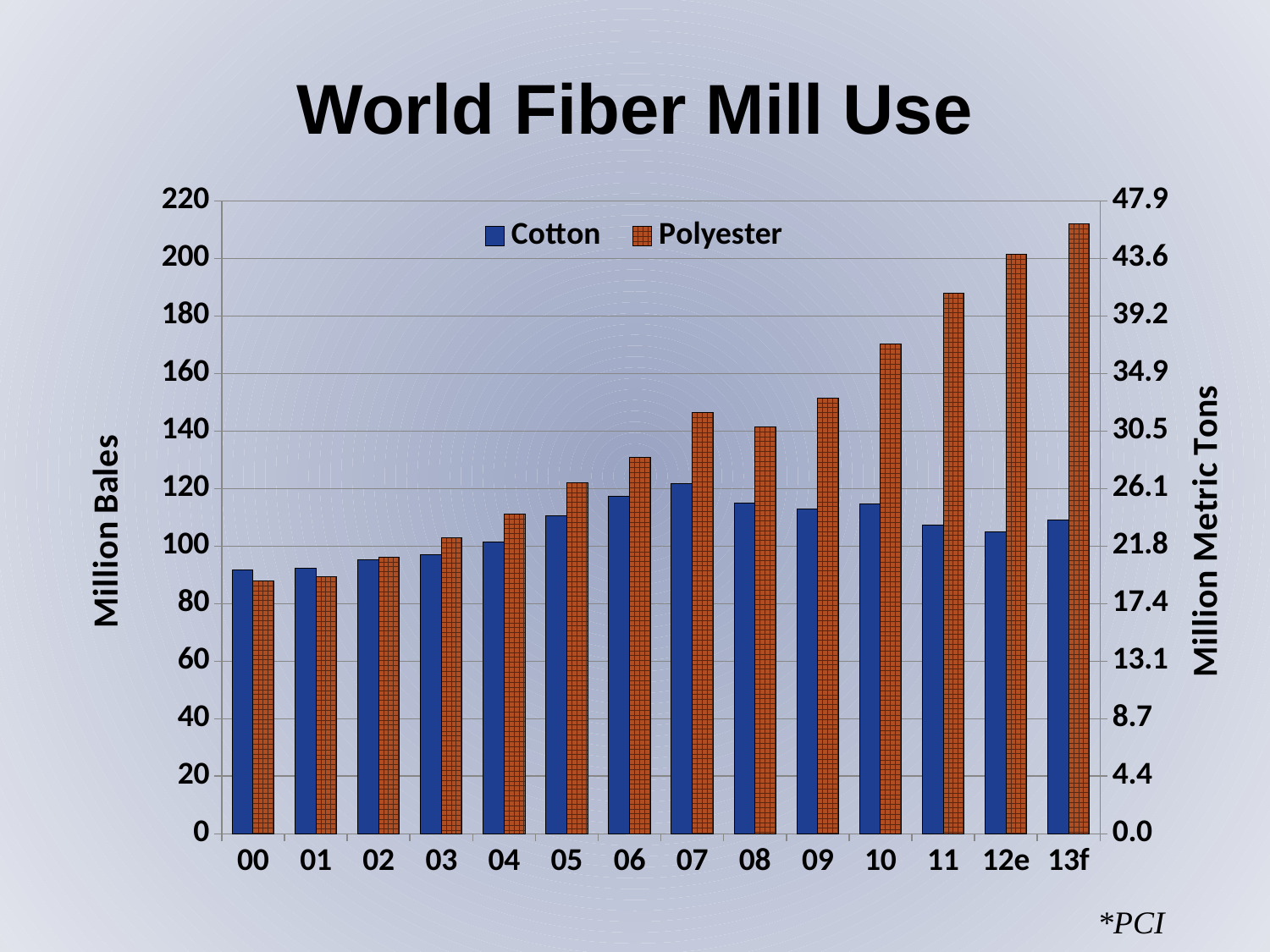
How many series does the legend list? 2 How many year categories are shown on the x axis? 14 Is the Cotton value for 07 greater or less than 120 million bales? greater Which is larger, the Cotton value for 07 or the Cotton value for 12e? 07 Do the Polyester values generally rise or fall from 00 to 13f? rise Which year has the highest Polyester value? 13f What is the label on the right-hand vertical axis? Million Metric Tons Is the Polyester value for 05 greater or less than 30.5 million metric tons? less What type of chart is shown on the slide? bar chart Which year has the highest Cotton value? 07 Is the Cotton value for 00 greater or less than 100 million bales? less